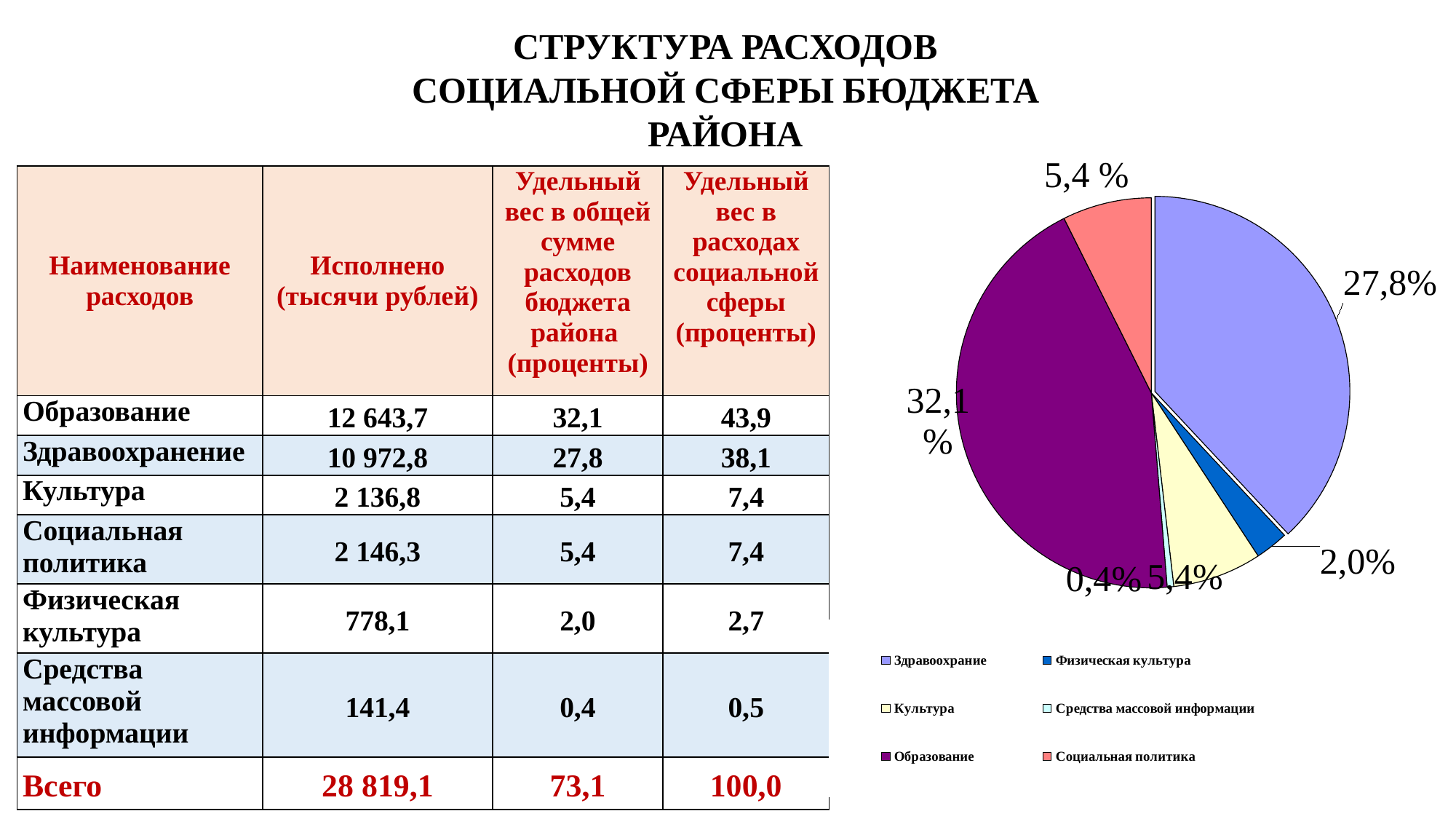
What is the difference in percentage points between the Образование and Здравоохранение slices in the pie chart? 4,3 Which category has the largest slice in the pie chart? Образование Which category has the smallest slice in the pie chart? Средства массовой информации What share of the pie chart does Физическая культура have? 2,0% How many categories does the pie chart's legend list? 6 What share of the pie chart does Средства массовой информации have? 0,4% What share of the pie chart does Здравоохранение have? 27,8% Which legend entry in the pie chart is shown in pink? Социальная политика In the pie chart, which slice is larger: Здравоохранение or Культура? Здравоохранение What share of the pie chart does Образование have? 32,1 % What kind of chart is shown on the slide? pie chart What colour is the Образование slice in the pie chart? purple